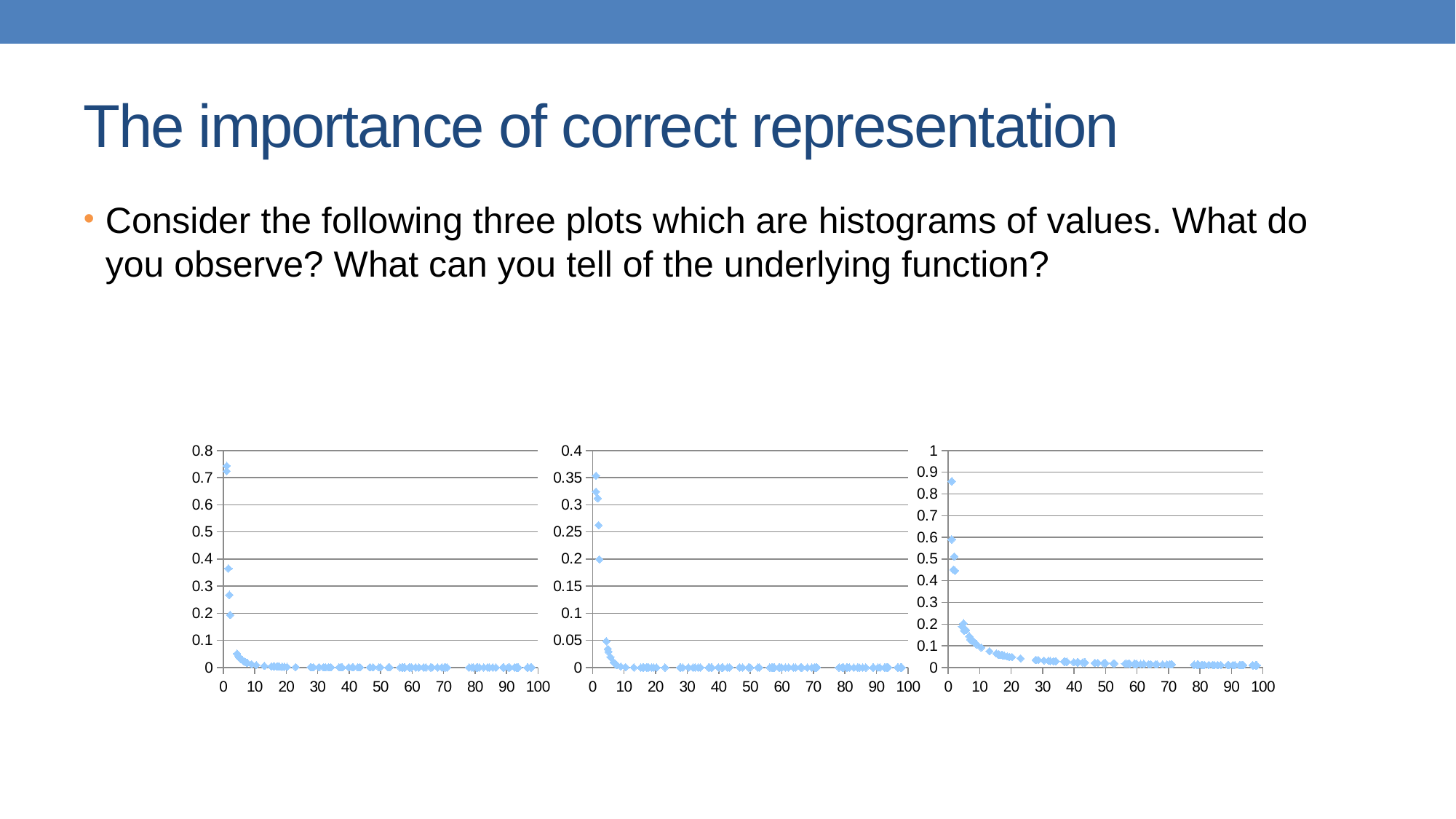
In the right-hand chart, are the values plotted near x = 50 greater or less than 0.1? less What kind of chart is the left-hand plot on the slide? scatter chart In the right-hand chart, do the plotted values rise or fall along the x axis? fall In the middle chart, are the values plotted near x = 80 greater or less than 0.05? less What is the maximum value shown on the x axis of the left-hand chart? 100 In the middle chart, is the highest plotted value greater or less than 0.3? greater In the left-hand chart, do the plotted values rise or fall as x increases from 0 to 100? fall What is the maximum value shown on the y axis of the middle chart? 0.4 What is the maximum value shown on the y axis of the right-hand chart? 1 How many charts are shown on the slide? 3